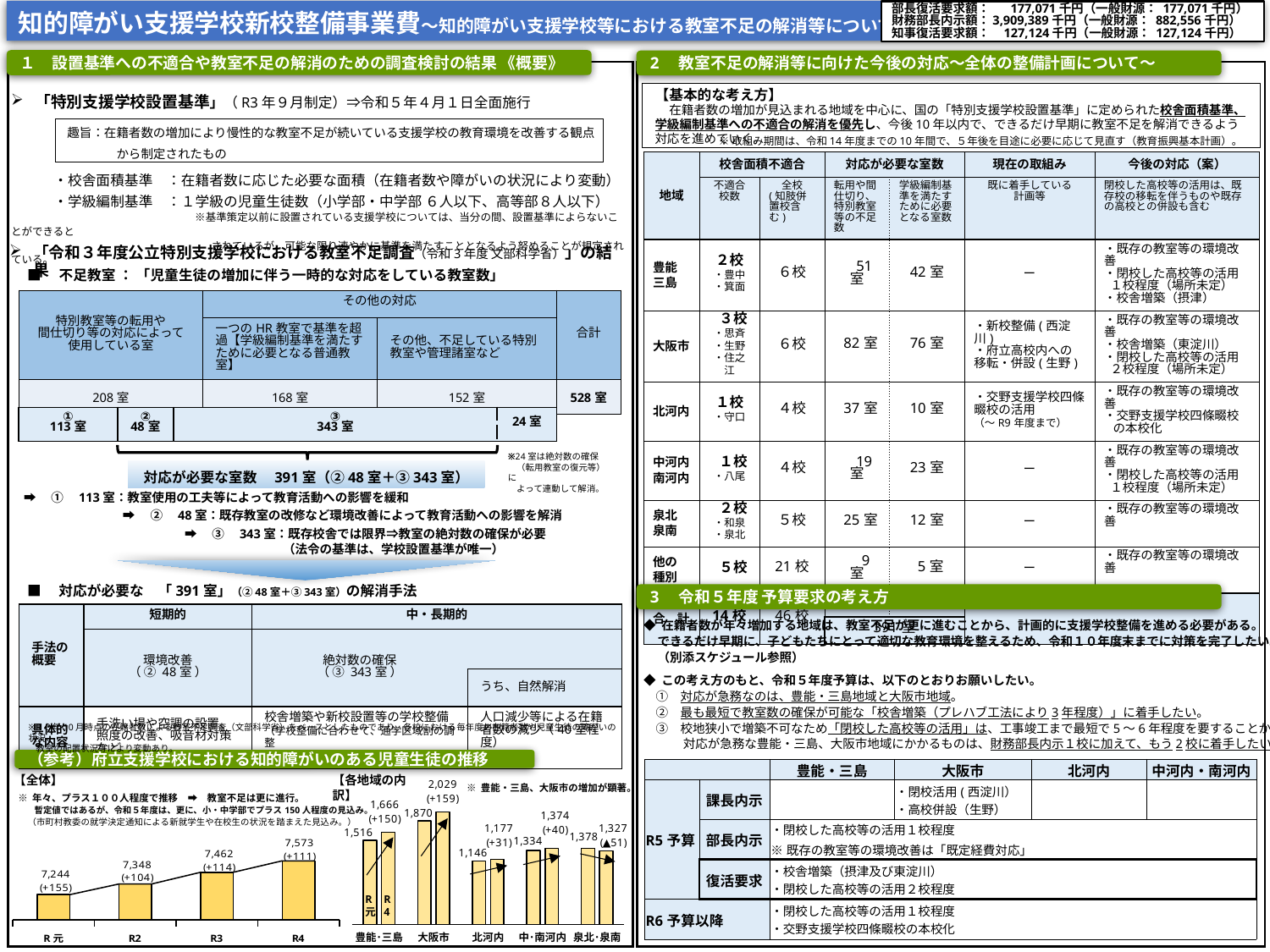
What kind of chart is the 【各地域の内訳】 chart at the bottom of the slide? bar chart In the 【全体】 chart at the bottom left, what is the value for R元? 7,244 In the 【全体】 chart at the bottom left, which year has the lowest value? R元 In the 【各地域の内訳】 chart, what is the R元 value for 北河内? 1,146 In the 【全体】 chart at the bottom left, what is the value for R4? 7,573 In the 【全体】 chart at the bottom left, do the values rise or fall from R元 to R4? rise In the 【各地域の内訳】 chart, which is larger for 泉北・泉南: the R元 value or the R4 value? R元 In the 【各地域の内訳】 chart, what is the R4 value for 大阪市? 2,029 In the 【全体】 chart at the bottom left, how many years are plotted? 4 In the 【全体】 chart at the bottom left, which year has the highest value? R4 In the 【全体】 chart at the bottom left, what is the difference between the R4 value and the R3 value? 111 In the 【各地域の内訳】 chart, which region has the highest R4 value? 大阪市